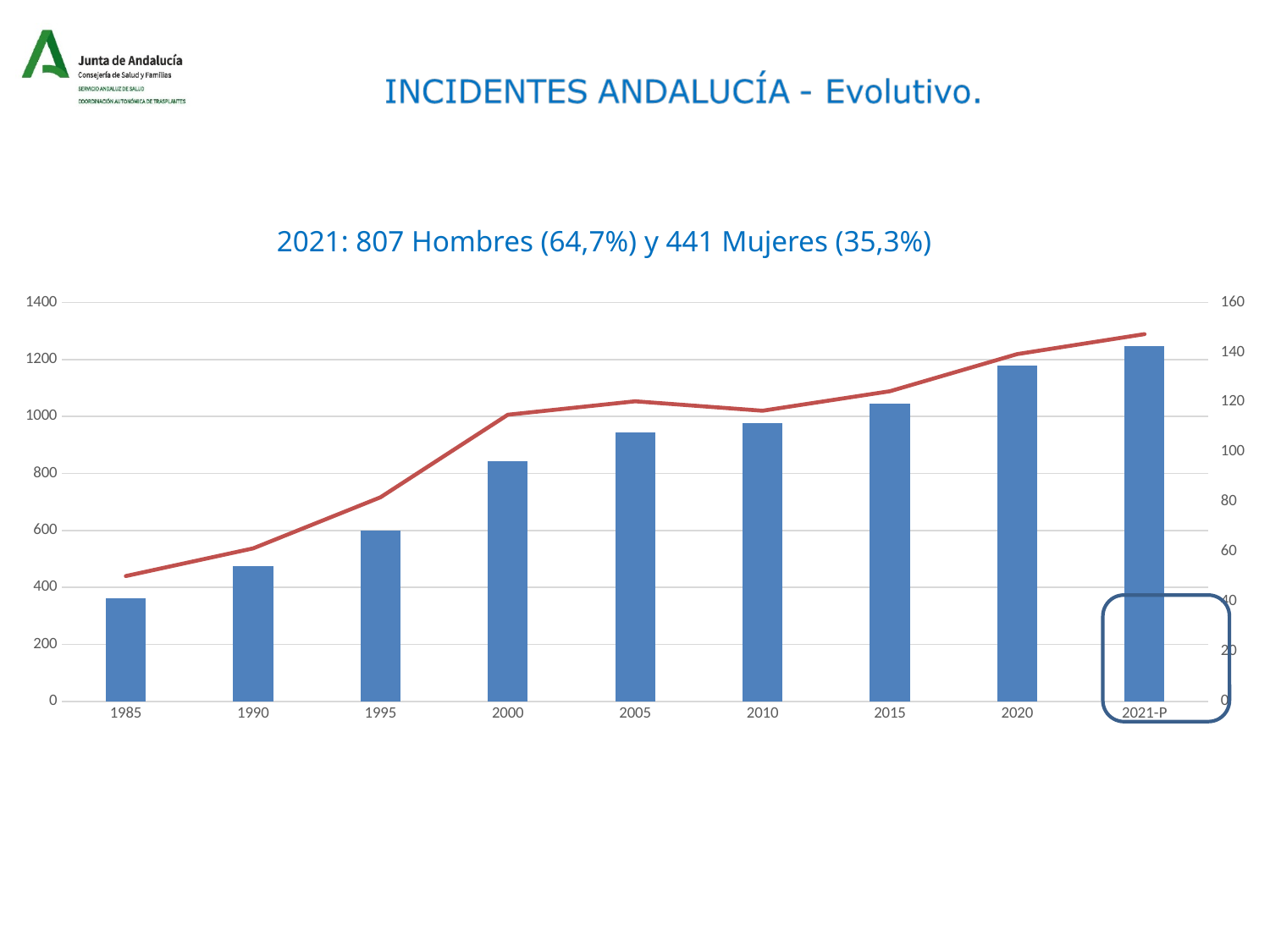
What is the title of the slide containing the chart? INCIDENTES ANDALUCÍA - Evolutivo. Is the bar value for 1985 greater or less than 400? less Is the line value for 2021-P, read on the right axis, greater or less than 140? greater Which has the taller bar, 2005 or 2015? 2015 How many categories are shown on the x axis of the chart? 9 Which category has the shortest bar? 1985 Is the bar value for 2000 greater or less than 800? greater Which category has the tallest bar? 2021-P Do the bar values generally rise or fall from 1985 to 2021-P? Rise What kind of chart is shown on the slide? Combined bar and line chart